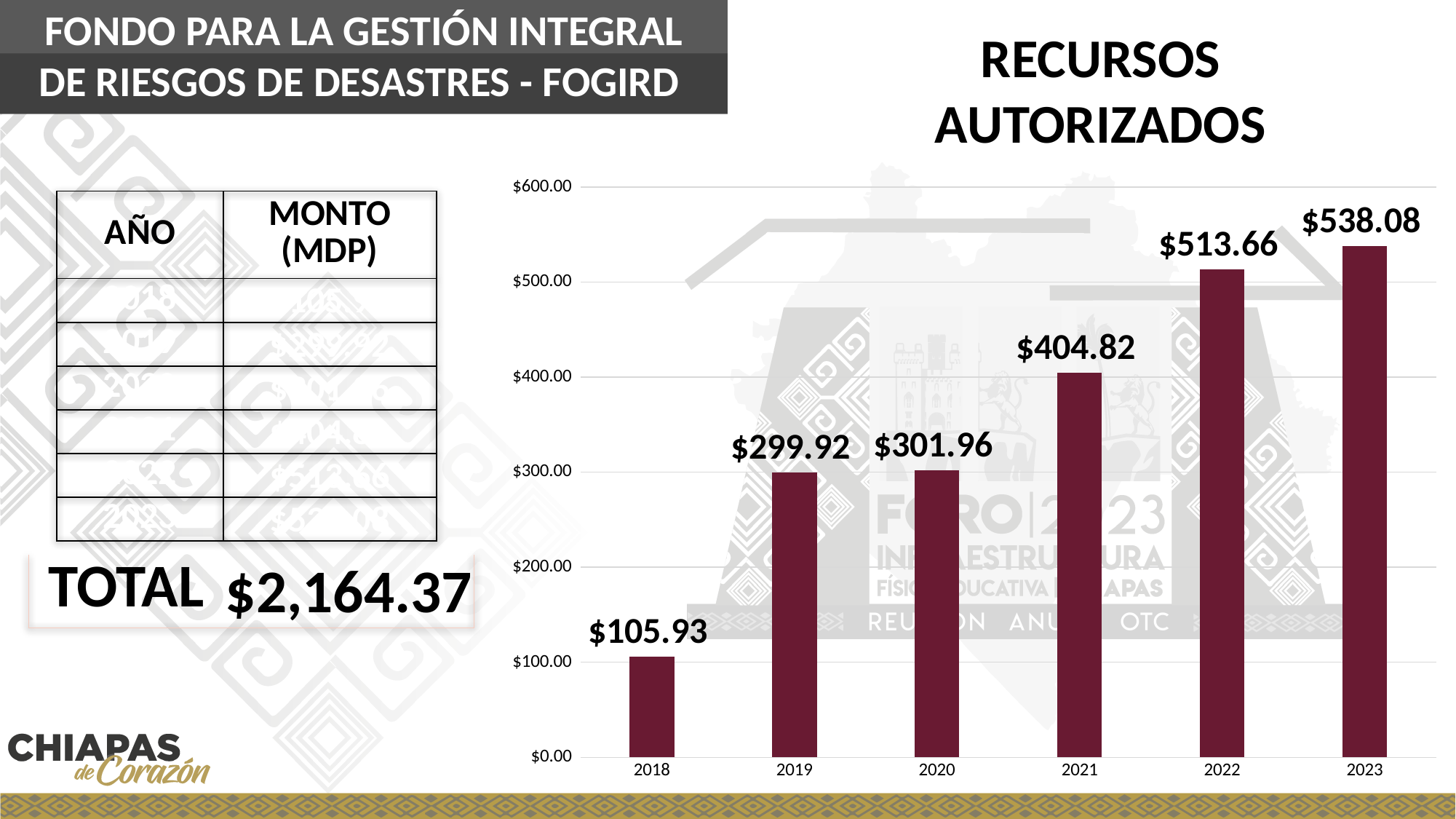
How many years are shown on the x axis? 6 What is the difference between the values for 2023 and 2022? $24.42 What kind of chart is shown? bar chart What is the difference between the values for 2021 and 2018? $298.89 Which is larger, the value for 2019 or the value for 2021? 2021 What is the value for 2023? $538.08 Which year has the lowest value? 2018 Is the value for 2022 greater or less than $500.00? greater Which year has the highest value? 2023 What is the value for 2021? $404.82 What is the value for 2018? $105.93 What is the title of the chart? RECURSOS AUTORIZADOS